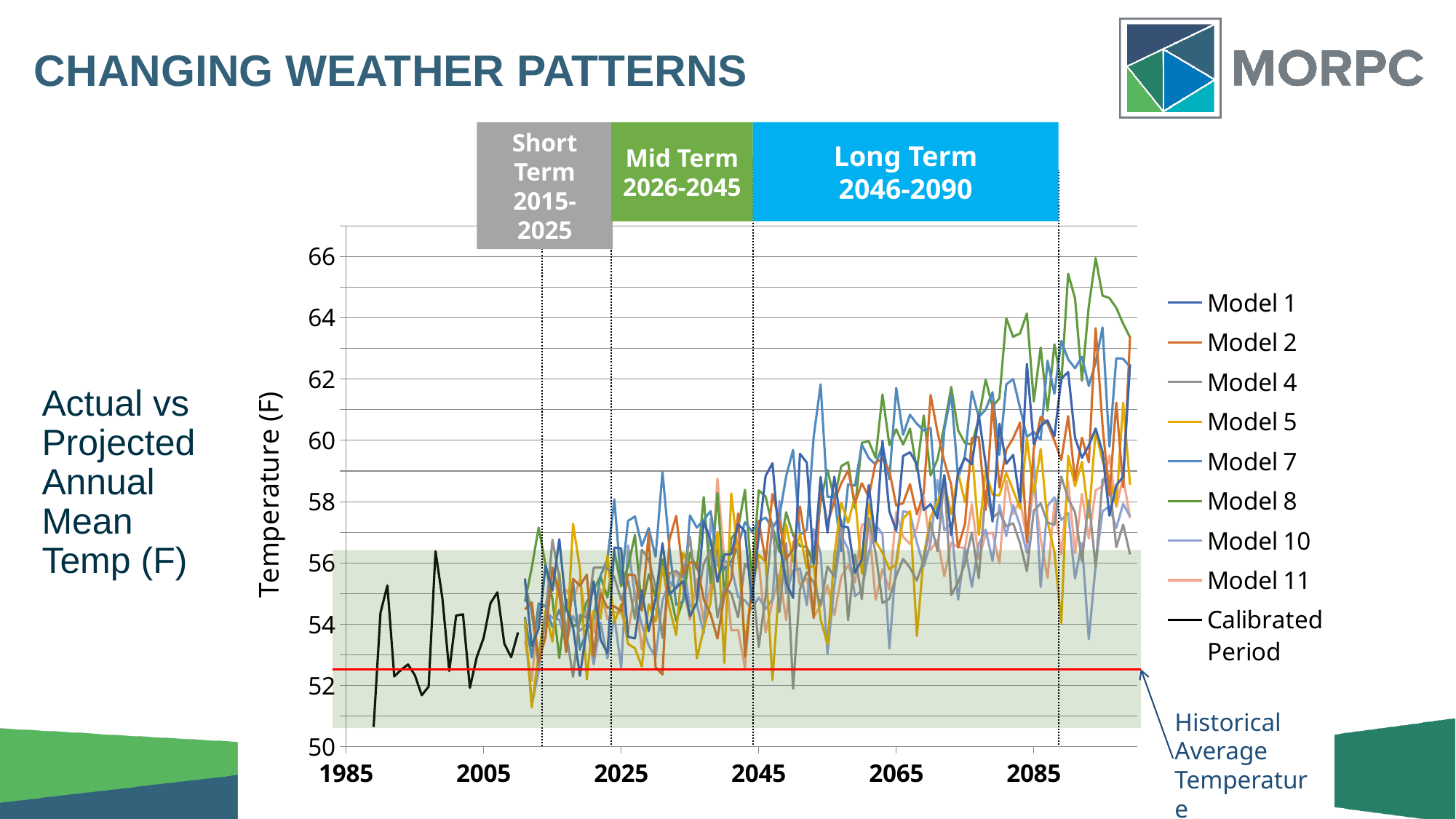
What kind of chart is shown on the slide? line chart What is the label of the vertical axis? Temperature (F) Do the projected model temperatures generally rise or fall from 2025 to 2090? rise Is the Historical Average Temperature line greater or less than 54? less What is the lowest value shown on the vertical axis? 50 How many entries does the chart legend list? 9 Are all values of the Calibrated Period series greater or less than 58? less Is the peak value of Model 8 greater or less than 64? greater What years does the Long Term period cover according to the chart? 2046-2090 What is the first year shown on the horizontal axis? 1985 Which model reaches the highest temperature on the chart? Model 8